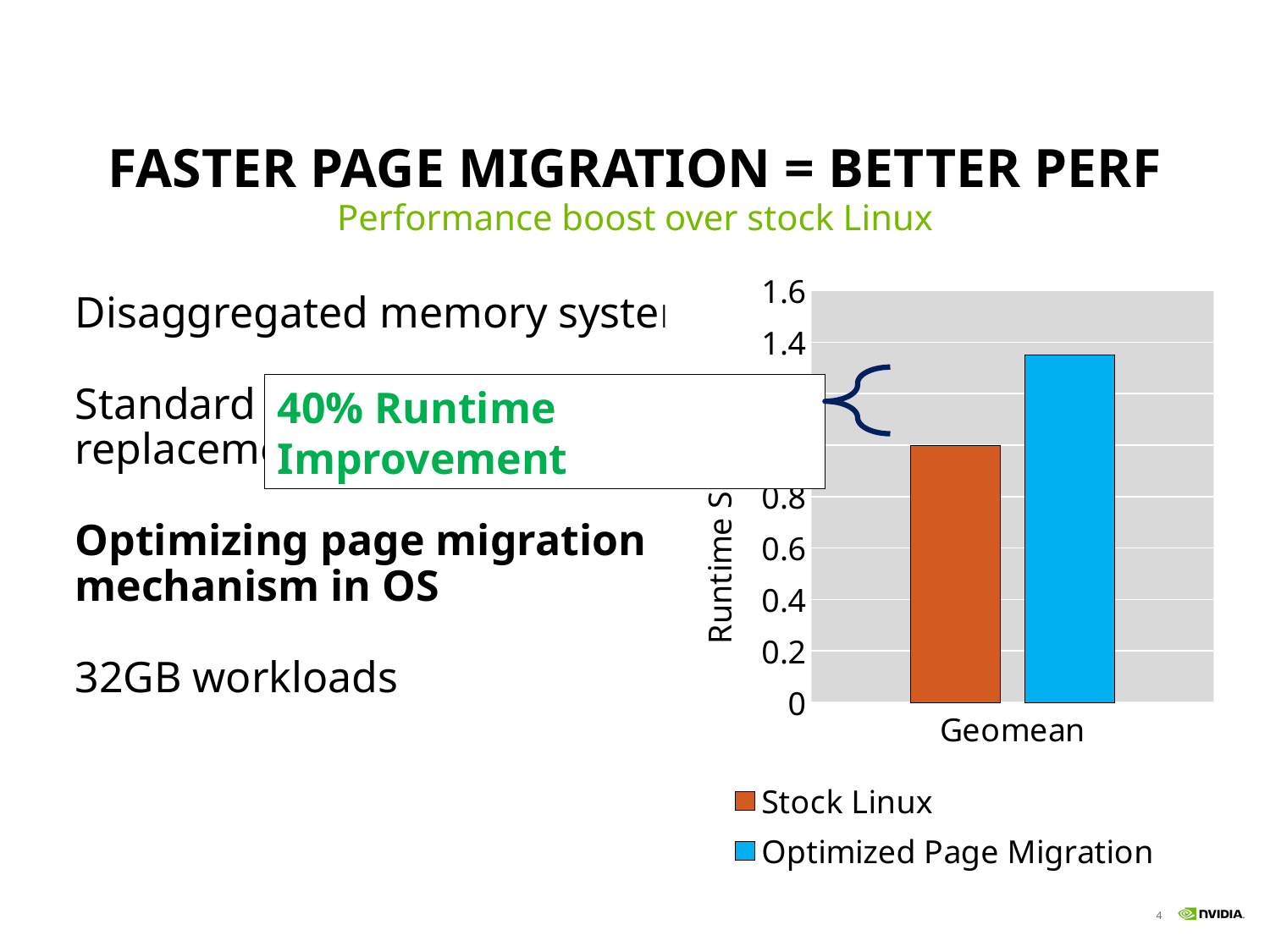
Is the value for Optimized Page Migration greater or less than 1.4? less Is the value for Stock Linux greater or less than 0.8? greater What kind of chart is shown on the slide? bar chart Which series has the highest bar in the chart? Optimized Page Migration Is the value for Optimized Page Migration greater or less than 1.2? greater How many series does the chart legend list? 2 What is the category label on the x axis of the chart? Geomean Which series has the lowest bar in the chart? Stock Linux What colour is the Stock Linux bar in the chart? orange How many categories are shown on the x axis of the chart? 1 Which series has the taller bar for Geomean, Stock Linux or Optimized Page Migration? Optimized Page Migration